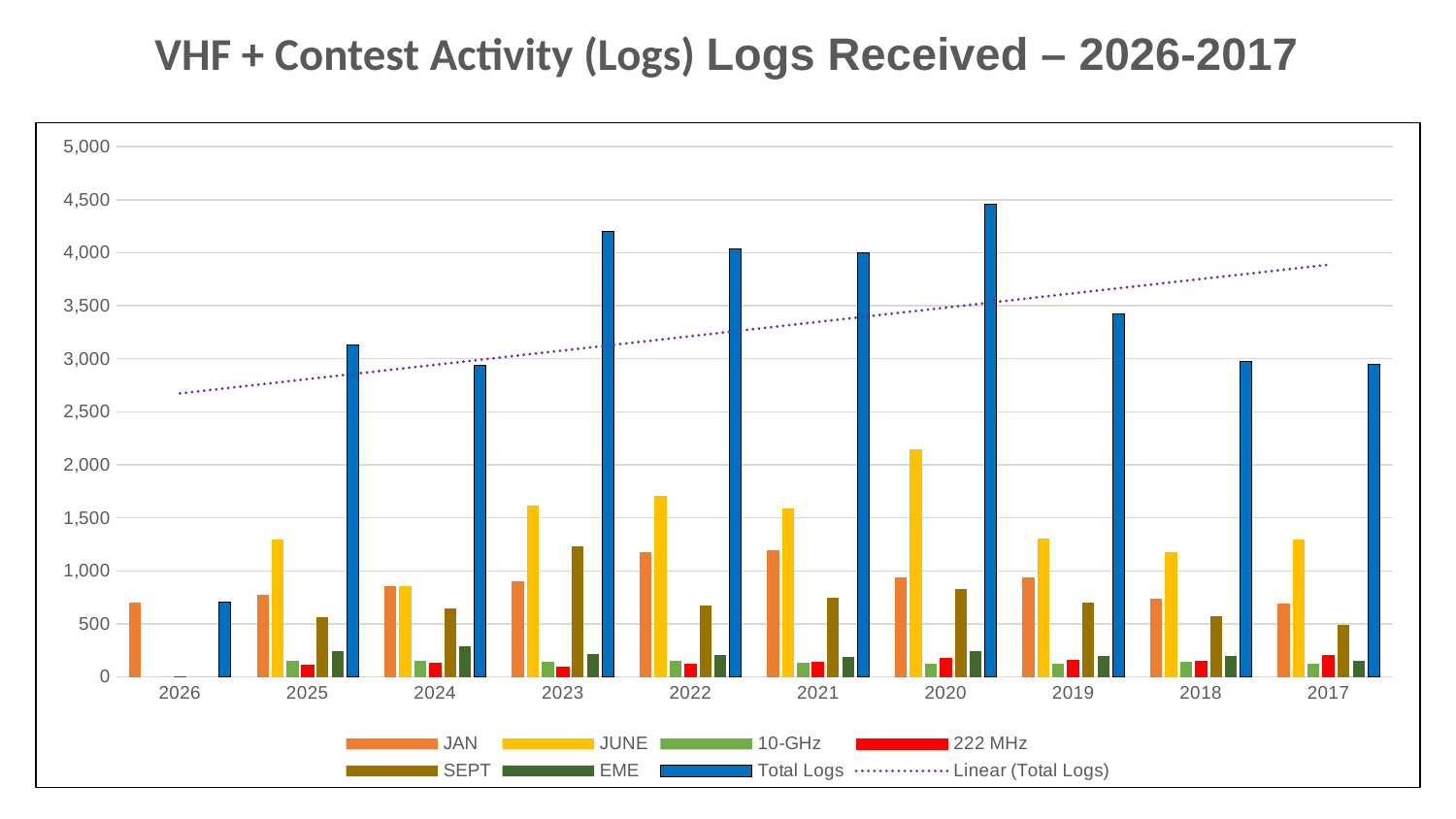
Which year has the lowest Total Logs value? 2026 Is the Total Logs value for 2026 greater or less than 1,000? less Is the Total Logs value for 2020 greater or less than 4,000? greater What kind of chart is shown on the slide? bar chart How many years are shown along the x axis? 10 Which is larger, the JUNE value for 2020 or the JUNE value for 2021? 2020 Is the JUNE value for 2020 greater or less than 2,000? greater How many entries does the legend list? 8 Does the Linear (Total Logs) trendline rise or fall from left to right across the x axis? rise What colour are the Total Logs bars? blue Which year has the highest Total Logs value? 2020 Which year has the highest JUNE value? 2020